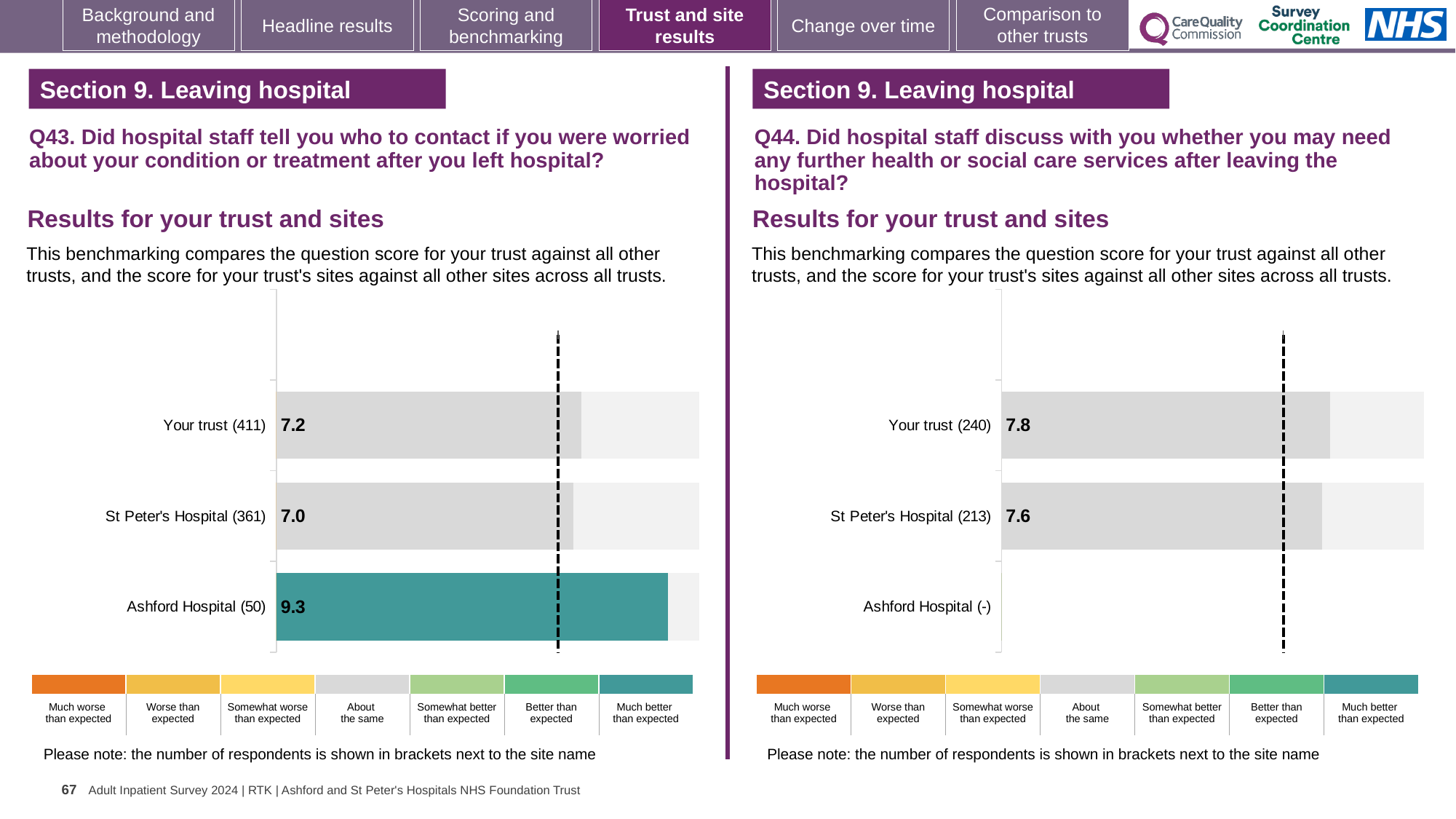
On the Q44 chart (right), which is larger, the score for Your trust or the score for St Peter's Hospital? Your trust On the Q43 chart (left), what is the score for St Peter's Hospital? 7.0 On the Q44 chart (right), how many respondents are shown in brackets for Your trust? 240 On the Q43 chart (left), which site or trust has the highest score? Ashford Hospital On the Q43 chart (left), what is the score for Your trust? 7.2 On the Q43 chart (left), which site or trust has the lowest score? St Peter's Hospital What kind of chart is used on the Q43 chart (left)? Bar chart On the Q43 chart (left), what is the score for Ashford Hospital? 9.3 On the Q44 chart (right), what is the score for St Peter's Hospital? 7.6 On the Q43 chart (left), which benchmark category does the colour of the Ashford Hospital bar correspond to? Much better than expected On the Q44 chart (right), what is the score for Your trust? 7.8 On the Q43 chart (left), what is the difference between the Ashford Hospital score and the St Peter's Hospital score? 2.3